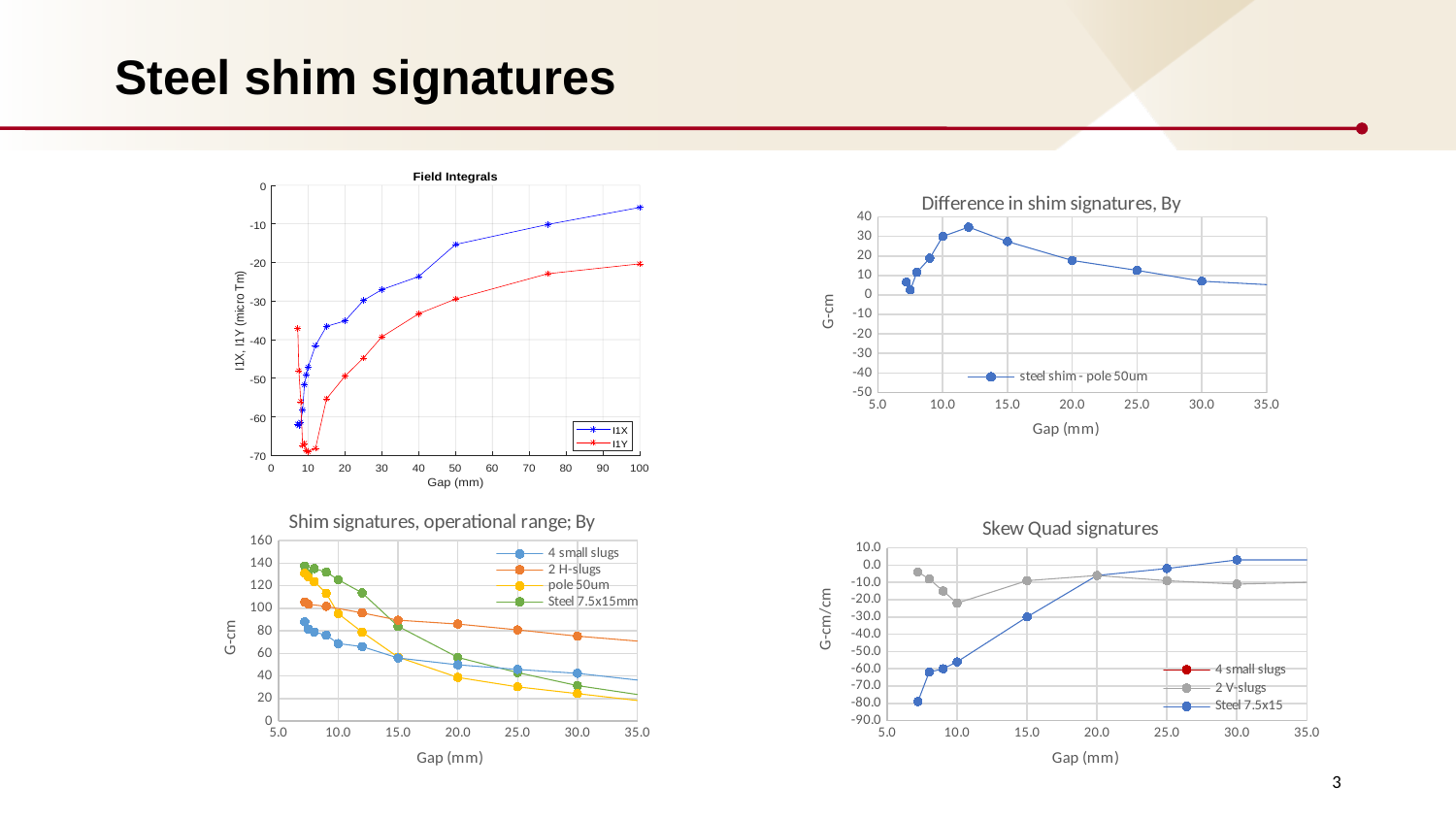
In the 'Shim signatures, operational range; By' chart, how many series does the legend list? 4 In the 'Difference in shim signatures, By' chart, do the values rise or fall as the gap increases from 15.0 to 35.0 mm? Fall In the 'Shim signatures, operational range; By' chart, which series has the highest value at a gap of 30.0 mm? 2 H-slugs How many charts are shown on the slide? 4 In the 'Skew Quad signatures' chart, how many series does the legend list? 3 In the 'Field Integrals' chart, does the I1X series rise or fall as the gap increases? Rises In the 'Field Integrals' chart, at a gap of 50 mm, which series has the larger value, I1X or I1Y? I1X In the 'Difference in shim signatures, By' chart, what is the legend entry for the plotted series? steel shim - pole 50um In the 'Difference in shim signatures, By' chart, is the value at a gap of 30.0 mm greater or less than 10? less What kind of chart is the 'Field Integrals' chart? Line chart In the 'Field Integrals' chart, how many series does the legend list? 2 In the 'Skew Quad signatures' chart, is the value for Steel 7.5x15 at a gap of 15.0 mm greater or less than -20.0? less